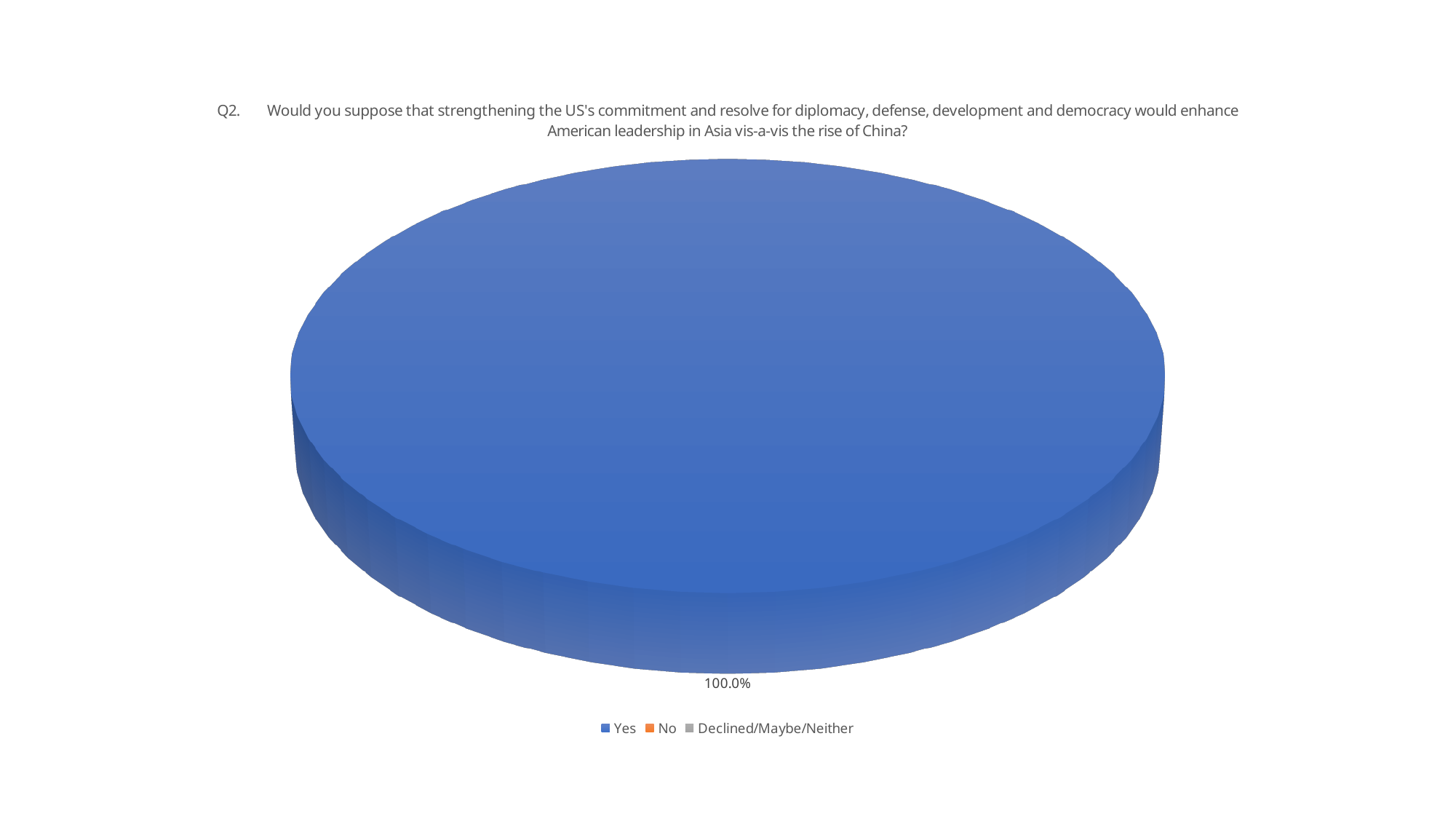
What kind of chart is shown on the slide? Pie chart What is the third legend entry listed after Yes and No? Declined/Maybe/Neither How many slices are visible in the pie? 1 What share of the pie does the Yes slice take? 100.0% What is the data label printed on the pie? 100.0% Is the share for Yes larger or smaller than the share for No? larger How many categories does the legend list? 3 Which category has the largest share of the pie? Yes Which legend entry is shown in orange? No